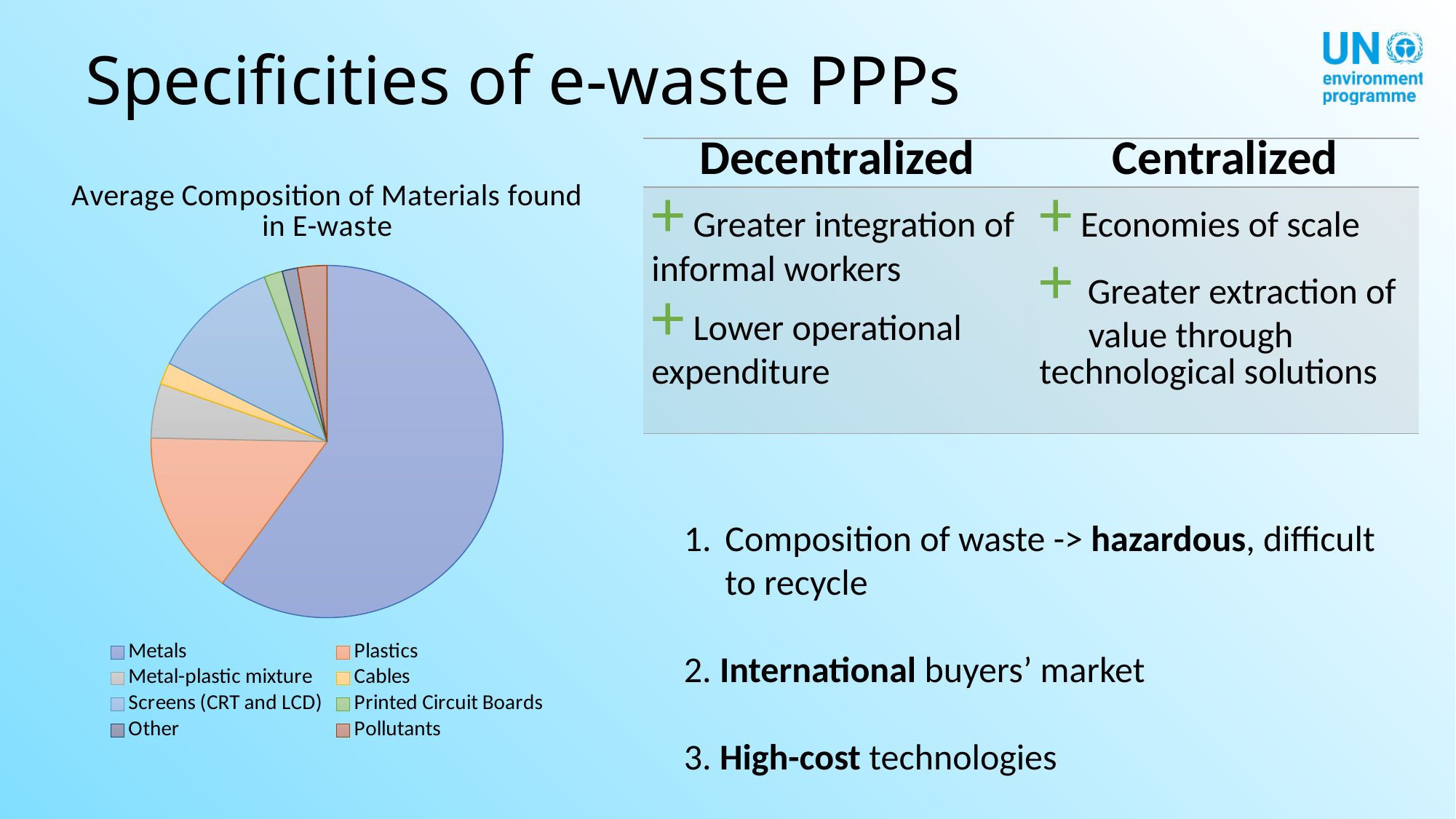
Which slice is larger in the pie chart, Screens (CRT and LCD) or Cables? Screens (CRT and LCD) Which slice is larger in the pie chart, Metal-plastic mixture or Printed Circuit Boards? Metal-plastic mixture What colour is the Plastics slice in the pie chart? orange What is the title of the chart on the slide? Average Composition of Materials found in E-waste What kind of chart is shown on the slide? pie chart Which slice is larger in the pie chart, Plastics or Screens (CRT and LCD)? Plastics Is the share of Metals in the pie chart greater or less than 50%? greater Which material makes up the largest slice of the pie chart? Metals How many material categories does the pie chart show? 8 Is the share of Plastics in the pie chart greater or less than 50%? less